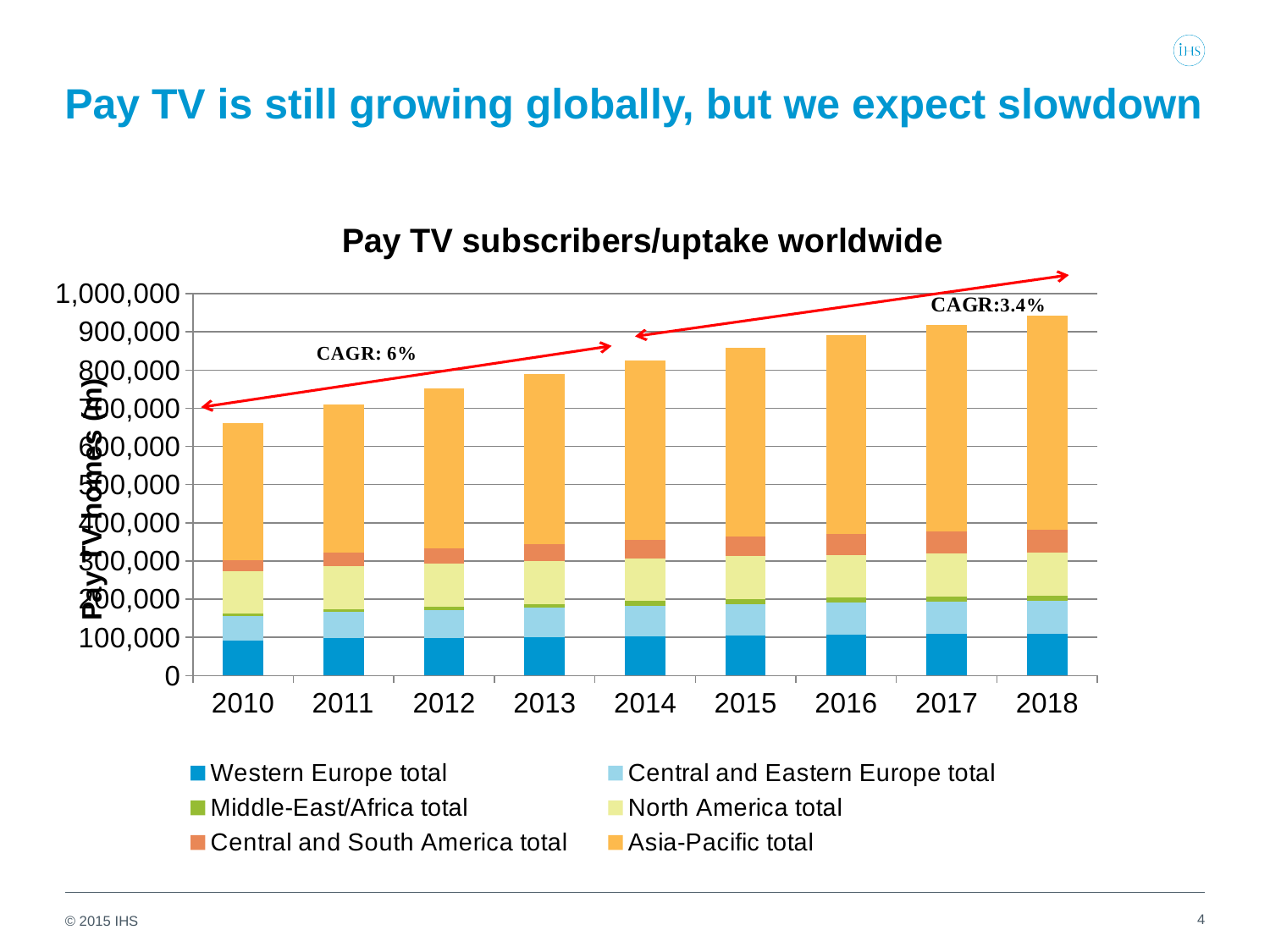
Is the total value for 2018 greater or less than 900,000? greater What is the title of the chart? Pay TV subscribers/uptake worldwide Is the total value for 2015 greater or less than 800,000? greater Is the total value for 2010 greater or less than 700,000? less How many series does the legend list? 6 How many years are shown on the x axis of the chart? 9 Which region accounts for the largest segment of each bar? Asia-Pacific total Do the total pay TV subscribers rise or fall from 2010 to 2018? Rise What kind of chart is shown on the slide? Stacked bar chart Which year has the highest total bar? 2018 Which year has the lowest total bar? 2010 What CAGR is annotated for the period from 2014 to 2018? 3.4%